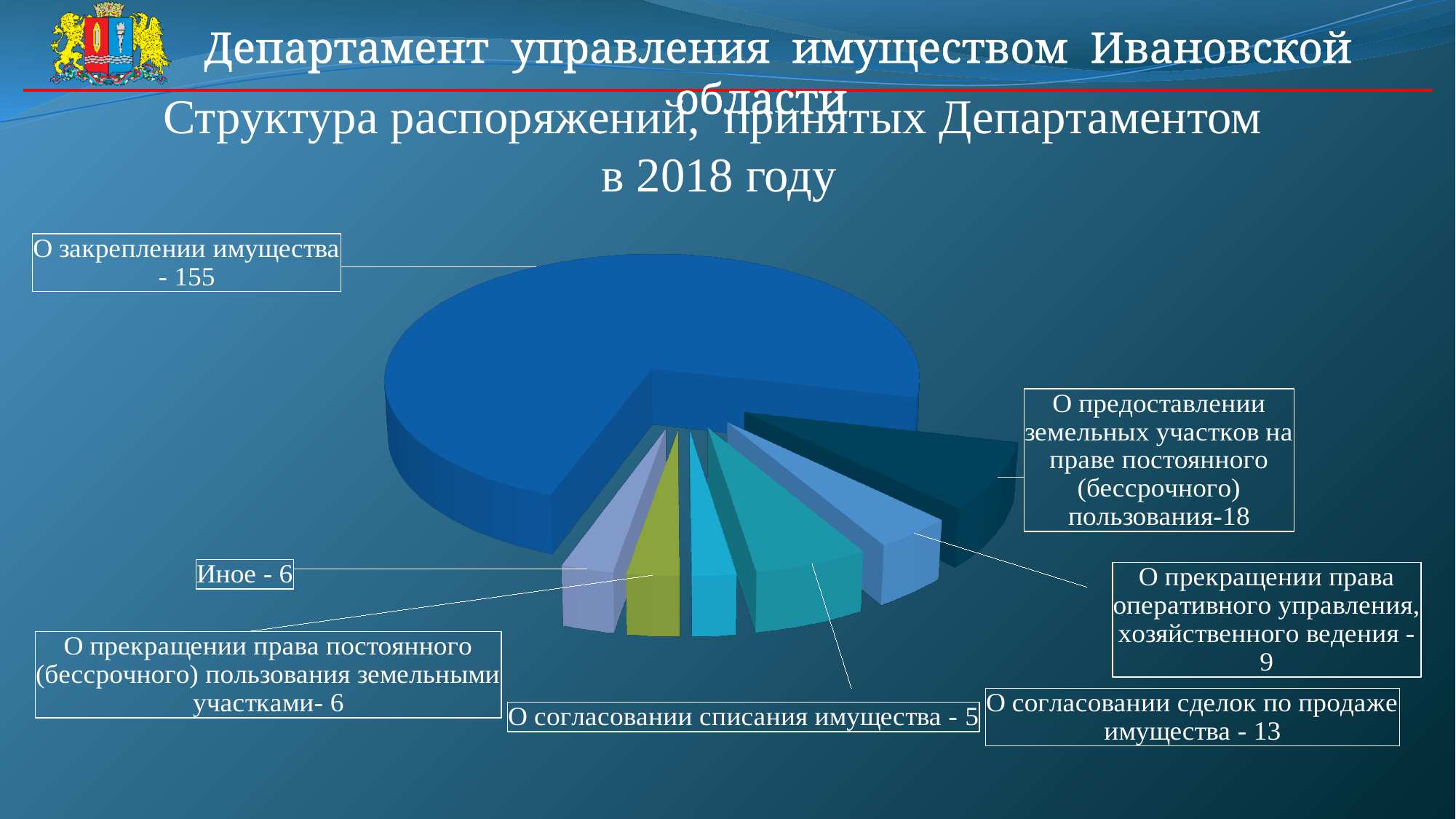
What kind of chart is shown on the slide? pie chart What is the value for "Иное"? 6 What is the value for "О закреплении имущества"? 155 What is the difference between the values for "О закреплении имущества" and "О предоставлении земельных участков на праве постоянного (бессрочного) пользования"? 137 Which category has the largest value in the pie chart? О закреплении имущества How many slices does the pie chart have? 7 Which category has the smallest value in the pie chart? О согласовании списания имущества What is the value for "О предоставлении земельных участков на праве постоянного (бессрочного) пользования"? 18 Which is larger: the value for "О согласовании сделок по продаже имущества" or for "О прекращении права оперативного управления, хозяйственного ведения"? О согласовании сделок по продаже имущества What year does the chart title say the data refers to? 2018 What is the value for "О согласовании сделок по продаже имущества"? 13 What is the value for "О прекращении права оперативного управления, хозяйственного ведения"? 9